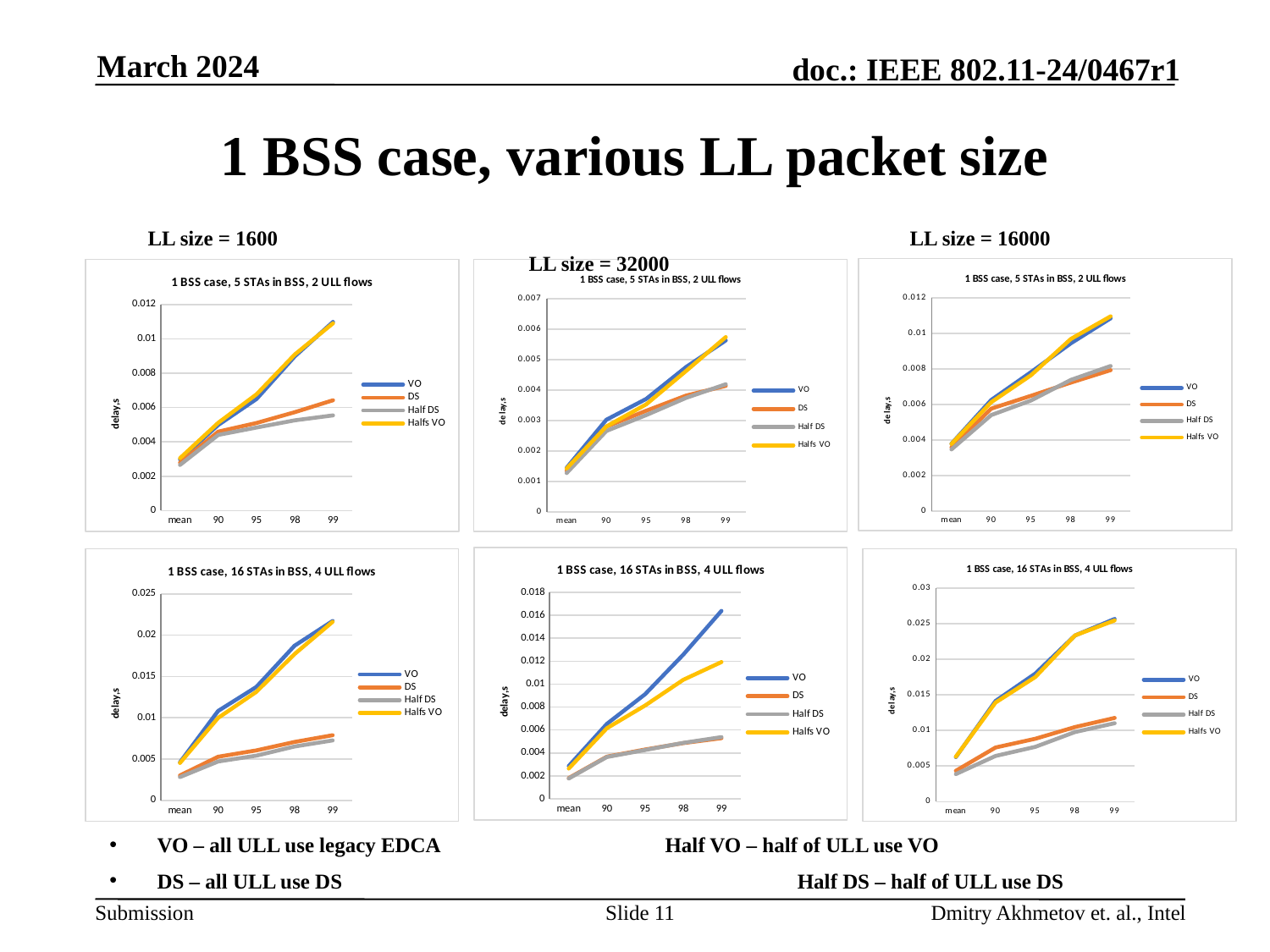
How many series does the legend list in the bottom-left chart (1 BSS case, 16 STAs in BSS, 4 ULL flows, LL size = 1600)? 4 In the bottom-left chart (LL size = 1600, 16 STAs in BSS, 4 ULL flows), is the DS value at 99 greater or less than 0.01? less In the top-left chart (LL size = 1600, 5 STAs in BSS, 2 ULL flows), is the VO value at 99 greater or less than 0.01? greater In the bottom-left chart (LL size = 1600, 16 STAs in BSS, 4 ULL flows), which is larger at 99: VO or DS? VO In the top-middle chart (LL size = 32000, 5 STAs in BSS, 2 ULL flows), do the VO values rise or fall from mean to 99? rise In the bottom-right chart (LL size = 16000, 16 STAs in BSS, 4 ULL flows), is the Half DS value at 99 greater or less than 0.015? less What is the y-axis label of the top-right chart (LL size = 16000, 5 STAs in BSS, 2 ULL flows)? delay,s What is the title of the bottom-right chart (LL size = 16000)? 1 BSS case, 16 STAs in BSS, 4 ULL flows In the bottom-middle chart (LL size = 32000, 16 STAs in BSS, 4 ULL flows), which series has the highest value at 99? VO How many categories are on the x axis of the top-right chart (LL size = 16000, 5 STAs in BSS, 2 ULL flows)? 5 What kind of chart is the top-left chart (LL size = 1600, 5 STAs in BSS, 2 ULL flows)? line chart